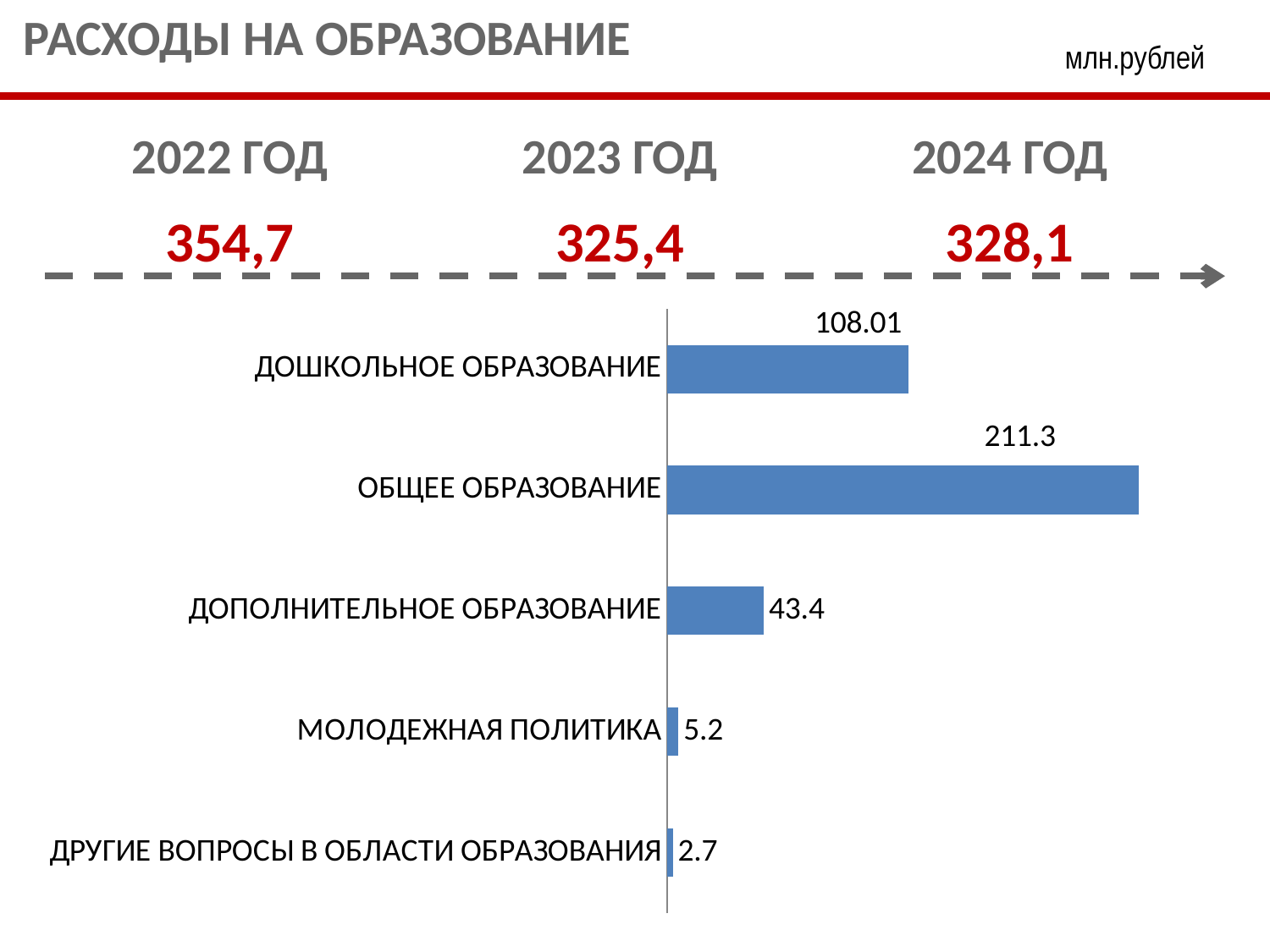
What is the difference between the values for ДОПОЛНИТЕЛЬНОЕ ОБРАЗОВАНИЕ and МОЛОДЕЖНАЯ ПОЛИТИКА in the bar chart? 38.2 What is the value for МОЛОДЕЖНАЯ ПОЛИТИКА in the bar chart? 5.2 How many categories are shown in the bar chart? 5 What is the difference between the values for ОБЩЕЕ ОБРАЗОВАНИЕ and ДОШКОЛЬНОЕ ОБРАЗОВАНИЕ in the bar chart? 103.29 Which category has the lowest value in the bar chart? ДРУГИЕ ВОПРОСЫ В ОБЛАСТИ ОБРАЗОВАНИЯ Which category has the highest value in the bar chart? ОБЩЕЕ ОБРАЗОВАНИЕ What is the value for ДОШКОЛЬНОЕ ОБРАЗОВАНИЕ in the bar chart? 108.01 What kind of chart is shown on the slide? Bar chart What is the value for ДОПОЛНИТЕЛЬНОЕ ОБРАЗОВАНИЕ in the bar chart? 43.4 What is the value for ДРУГИЕ ВОПРОСЫ В ОБЛАСТИ ОБРАЗОВАНИЯ in the bar chart? 2.7 Which is larger in the bar chart: ДОШКОЛЬНОЕ ОБРАЗОВАНИЕ or ДОПОЛНИТЕЛЬНОЕ ОБРАЗОВАНИЕ? ДОШКОЛЬНОЕ ОБРАЗОВАНИЕ What is the value for ОБЩЕЕ ОБРАЗОВАНИЕ in the bar chart? 211.3